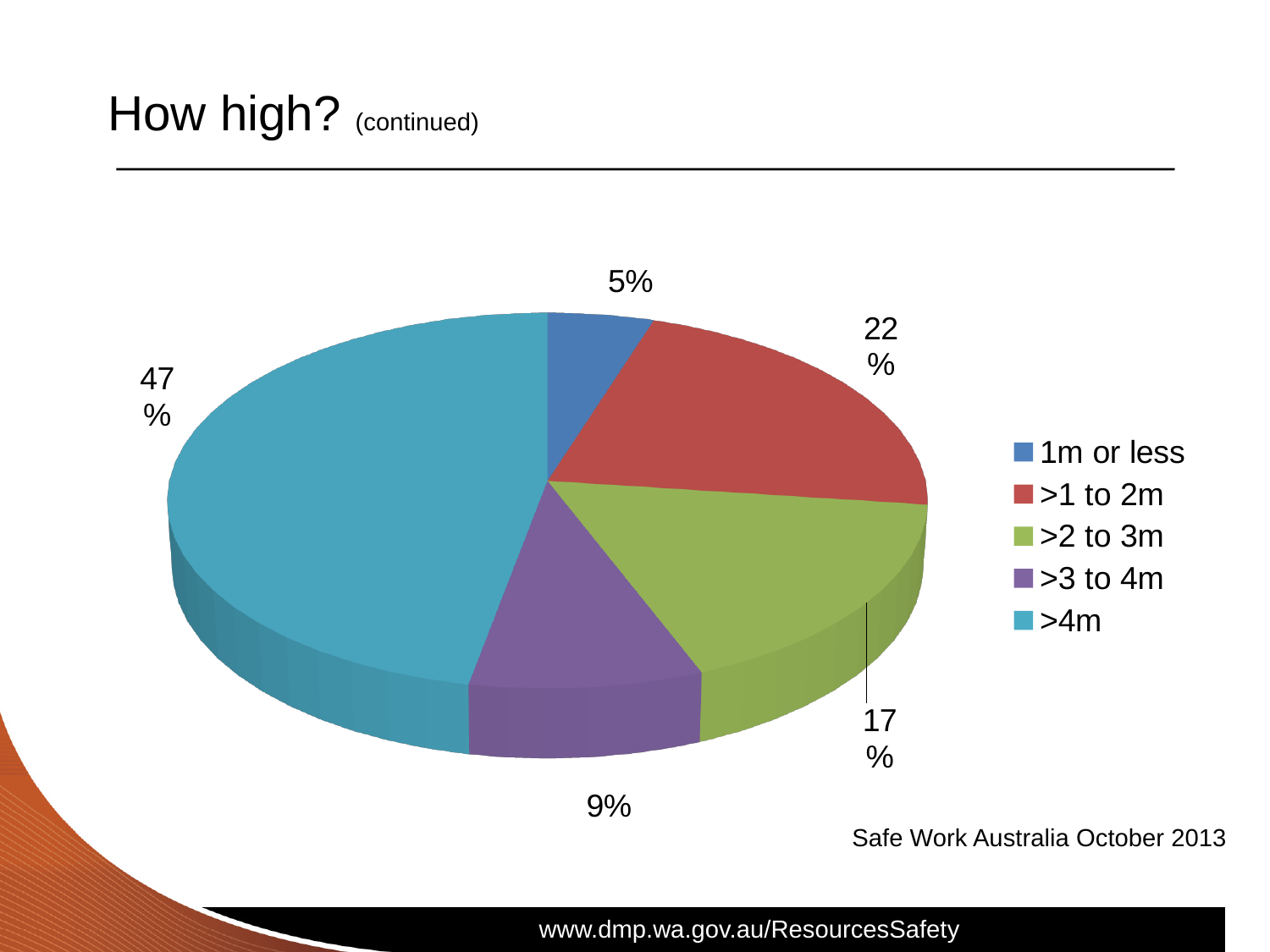
What percentage does the >2 to 3m slice represent? 17% What percentage does the >1 to 2m slice represent? 22% What colour is the >4m slice? light blue How many categories does the legend list? 5 Which category has the smallest share of the pie? 1m or less Which is larger, the >2 to 3m slice or the >3 to 4m slice? >2 to 3m What percentage does the >4m slice represent? 47% What percentage does the >3 to 4m slice represent? 9% What percentage does the 1m or less slice represent? 5% What kind of chart is shown on the slide? pie chart Which category has the largest share of the pie? >4m What is the difference in percentage points between the >4m slice and the >1 to 2m slice? 25